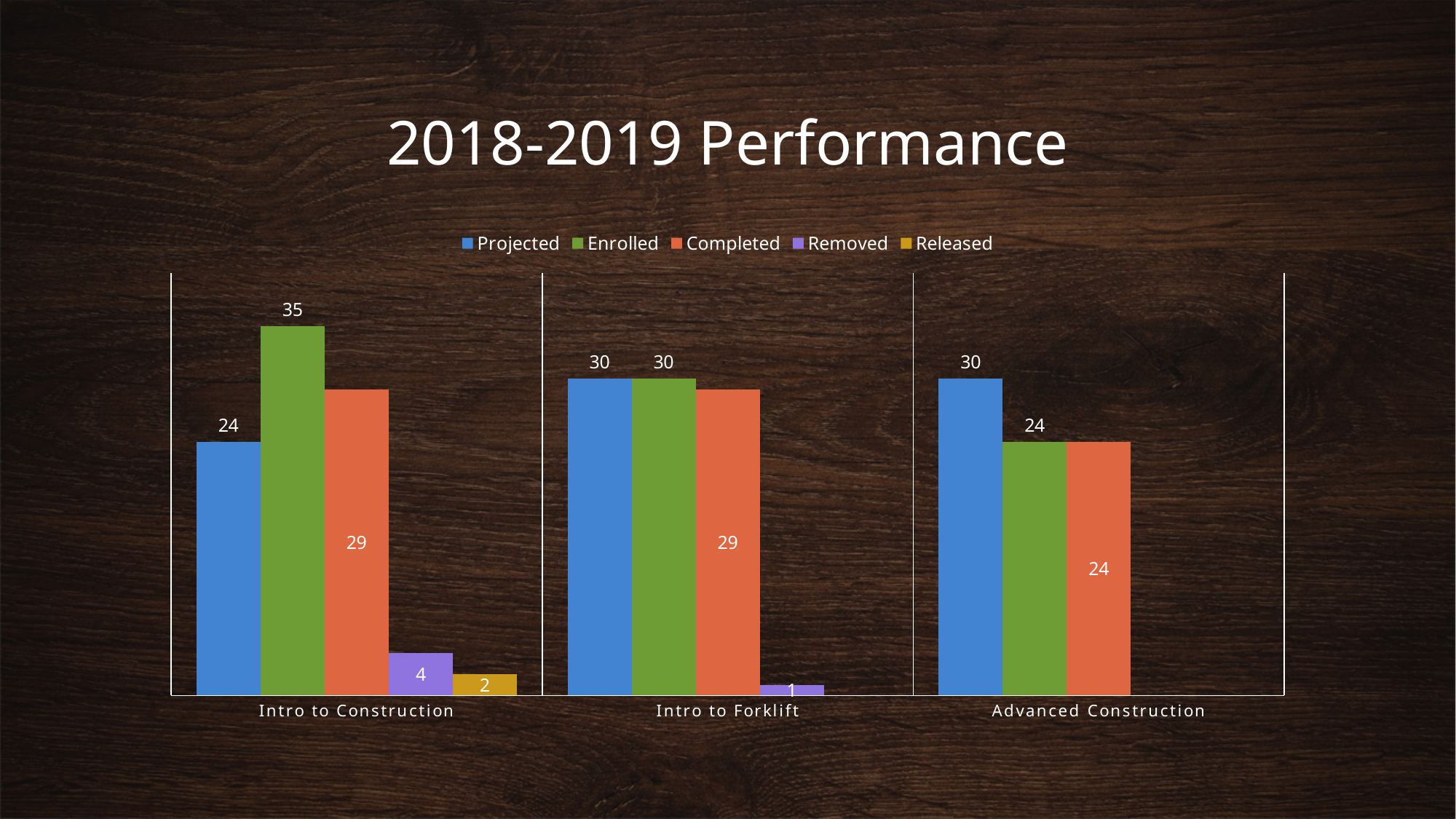
Which category has the highest Enrolled value? Intro to Construction How many categories are shown on the x axis? 3 What is the Released value for Intro to Construction? 2 Is the Projected value for Intro to Construction larger or smaller than the Projected value for Intro to Forklift? smaller What is the difference between the Enrolled and Projected values for Intro to Construction? 11 How many series does the legend list? 5 What is the Projected value for Advanced Construction? 30 Which category has the lowest Completed value? Advanced Construction What is the Completed value for Intro to Forklift? 29 What is the Enrolled value for Intro to Construction? 35 What kind of chart is shown on the slide? bar chart What is the Removed value for Intro to Construction? 4